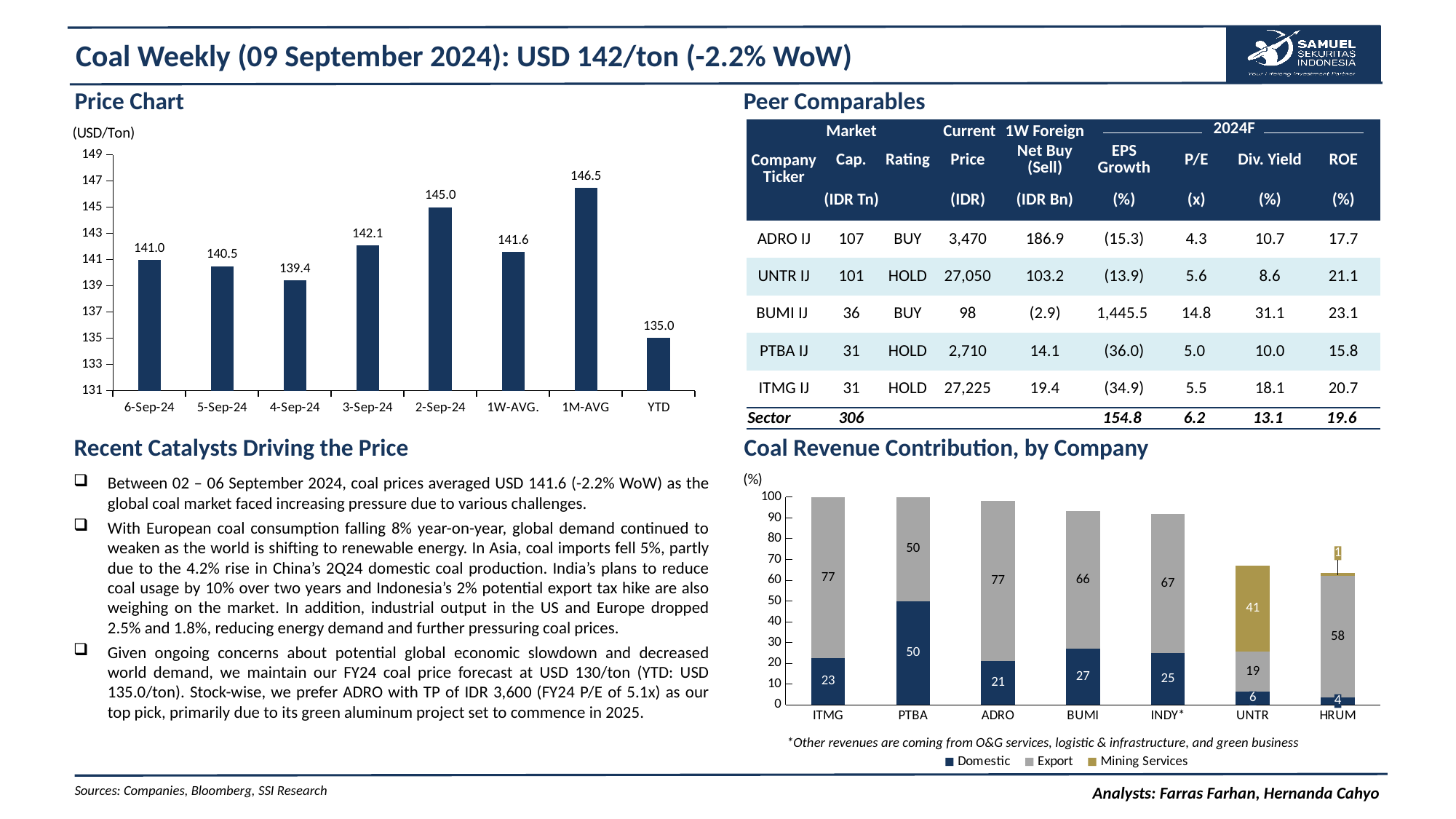
In the Price Chart, what is the difference between the 1M-AVG value and the 1W-AVG. value? 4.9 In the Price Chart, which is larger, the value for 3-Sep-24 or the value for 4-Sep-24? 3-Sep-24 In the Price Chart, which category has the lowest value? YTD In the Price Chart, what is the value for 2-Sep-24? 145.0 In the Price Chart, how many bars are plotted? 8 In the Price Chart, which category has the highest value? 1M-AVG In the Coal Revenue Contribution, by Company chart, what is the total of the stacked bar for BUMI? 93 In the Coal Revenue Contribution, by Company chart, what is the Export value for HRUM? 58 In the Coal Revenue Contribution, by Company chart, how many series does the legend list? 3 What kind of chart is the Coal Revenue Contribution, by Company chart? Stacked bar chart In the Coal Revenue Contribution, by Company chart, what is the Mining Services value for UNTR? 41 In the Price Chart, what is the YTD value? 135.0